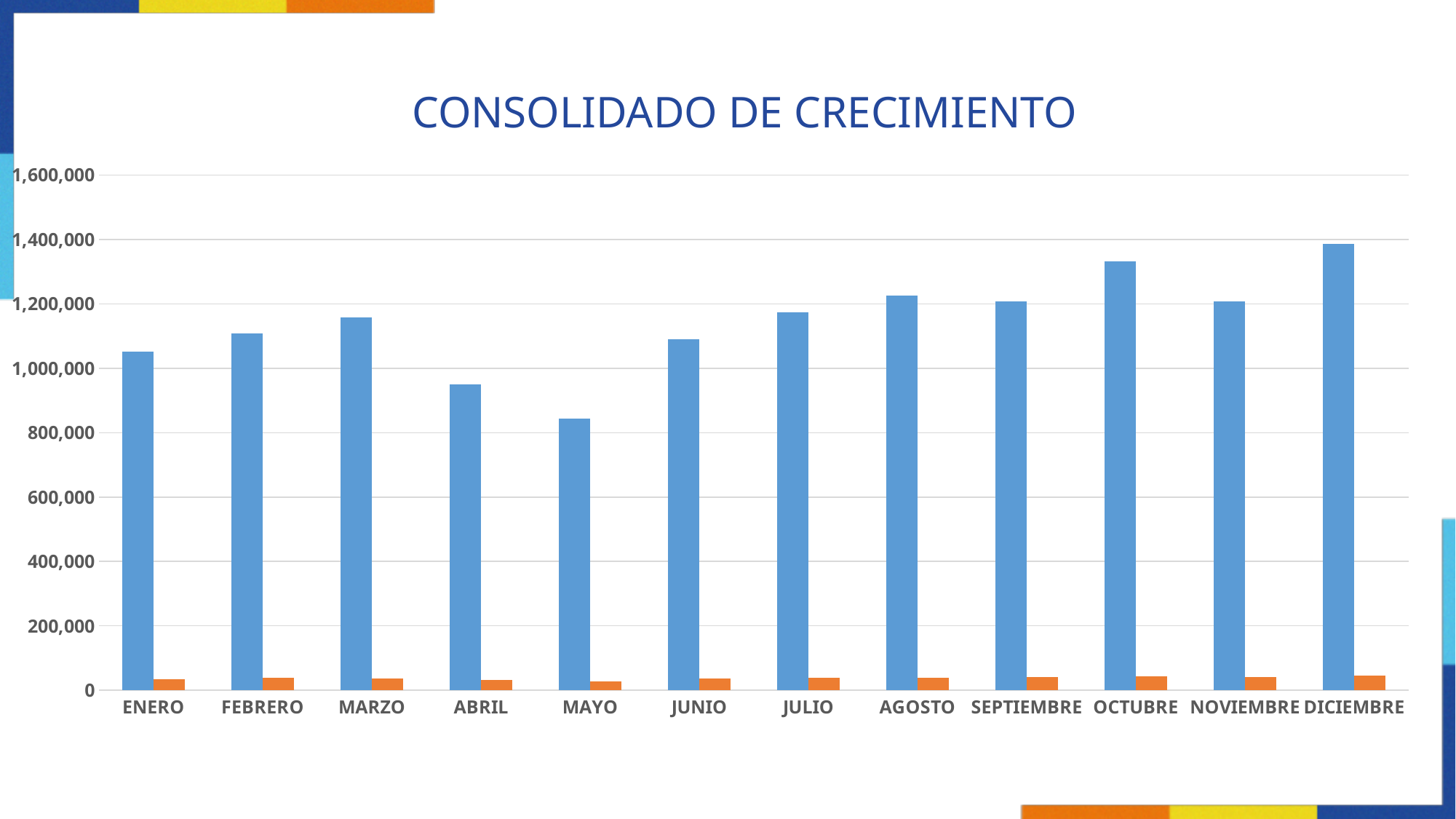
Do the blue bars rise or fall from MAYO to AGOSTO? rise Is the blue bar value for ABRIL greater or less than 1,000,000? less Is the blue bar value for DICIEMBRE greater or less than 1,200,000? greater Which month has the tallest blue bar? DICIEMBRE What is the title of the chart? CONSOLIDADO DE CRECIMIENTO How many months (categories) are shown on the x axis? 12 Which has the larger blue bar, OCTUBRE or NOVIEMBRE? OCTUBRE Is the blue bar value for MAYO greater or less than 1,000,000? less What type of chart is shown on the slide? bar chart Which month has the shortest blue bar? MAYO Which has the larger blue bar, MARZO or ABRIL? MARZO